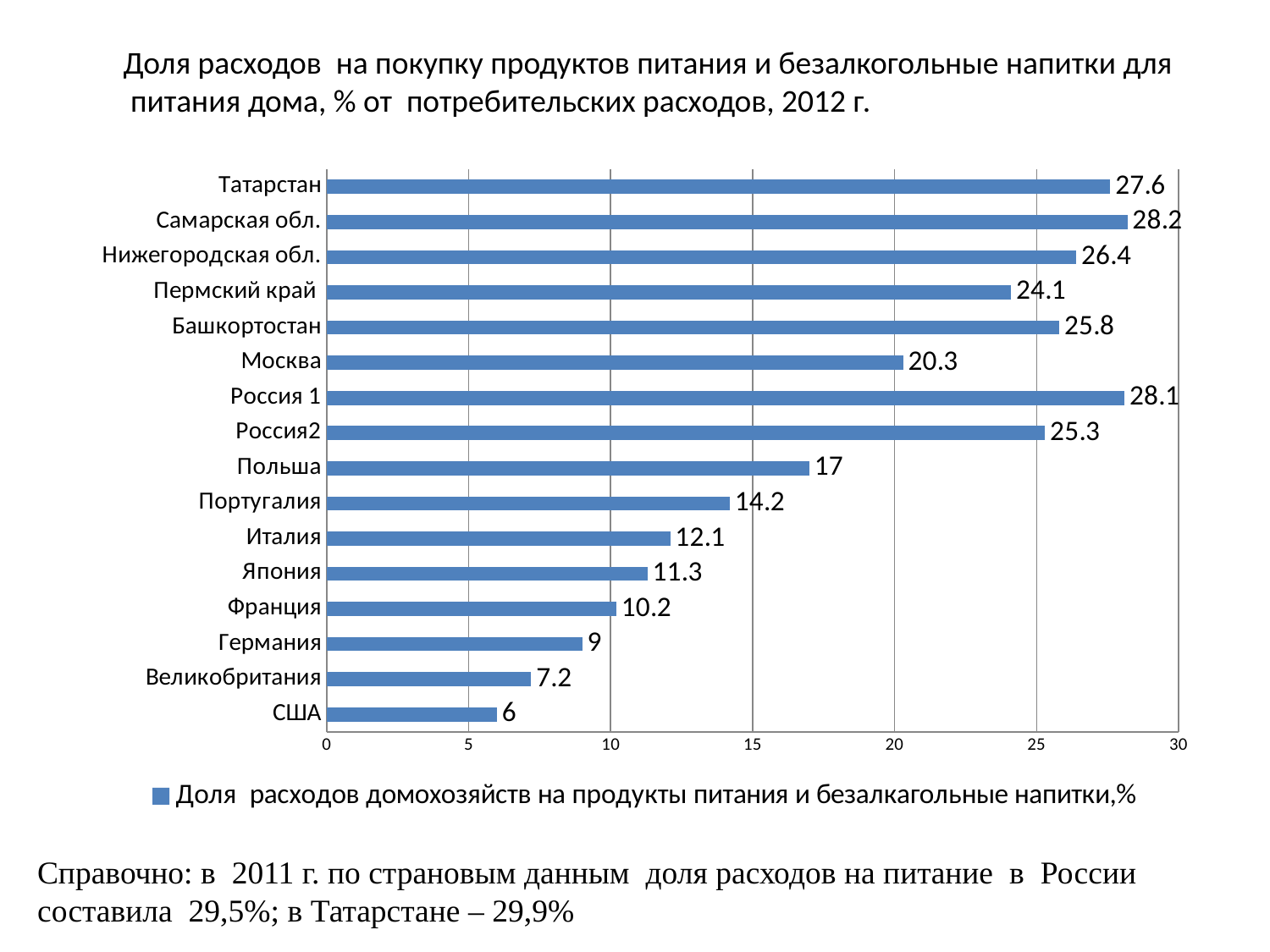
What is the value for Япония? 11.3 What kind of chart is shown on the slide? bar chart Which is larger, the value for Германия or the value for Франция? Франция What is the value for Москва? 20.3 What is the value for Татарстан? 27.6 What is the difference between the values for Россия 1 and Россия2? 2.8 How many series does the legend list? 1 Is the value for Португалия greater or less than 15? less Which category has the lowest value? США Which category has the highest value? Самарская обл. How many categories are shown in the chart? 16 What is the difference between the values for Татарстан and Польша? 10.6